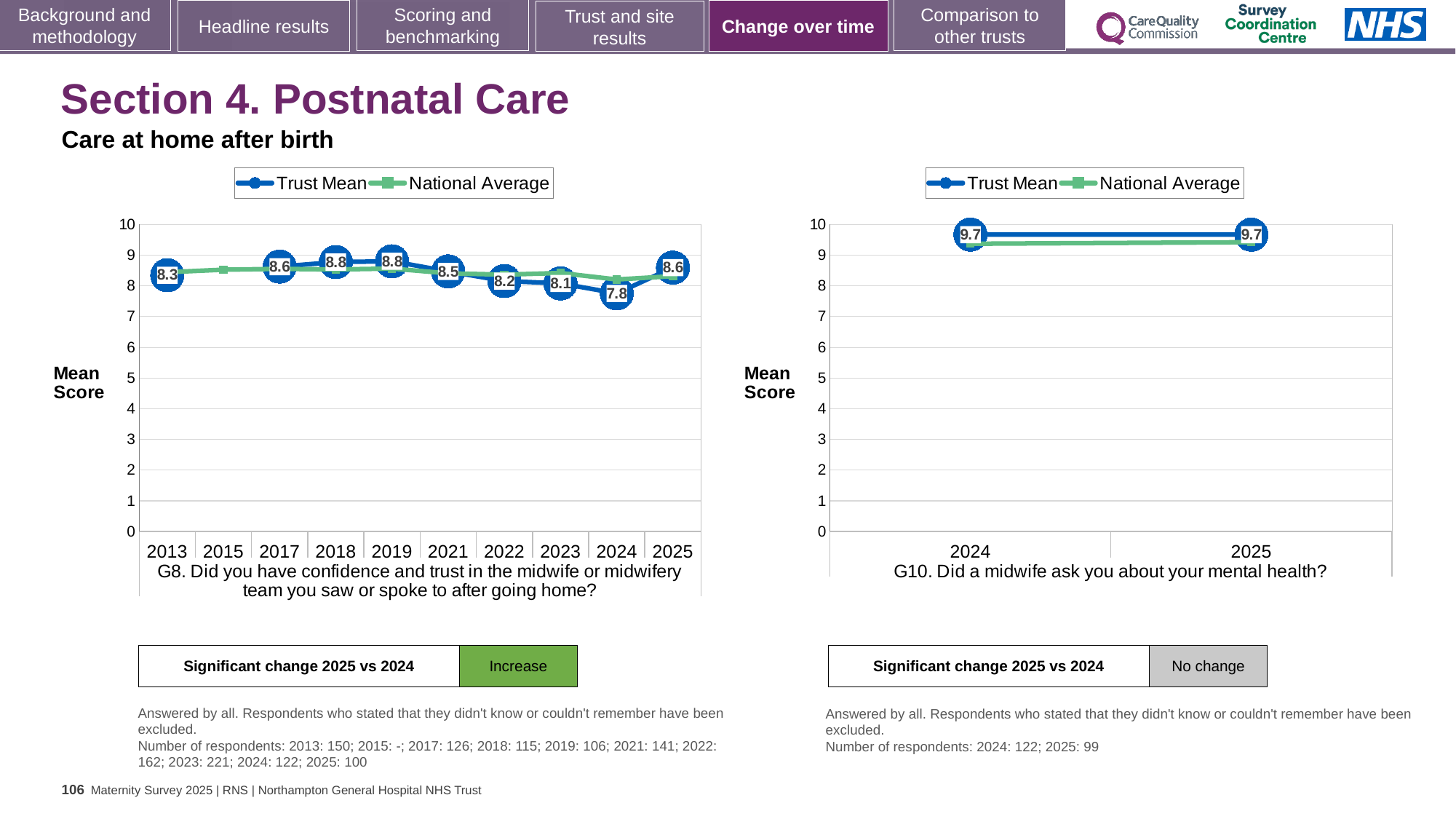
How many series does the legend of the G10 chart list? 2 In the G8 chart, which is larger, the Trust Mean for 2018 or for 2022? 2018 In the G8 chart, what is the Trust Mean score for 2024? 7.8 How many years are shown on the x axis of the G8 chart? 10 In the G10 chart, what is the difference between the Trust Mean scores for 2024 and 2025? 0 In the G8 chart, which year has the lowest Trust Mean score? 2024 In the G10 chart, what is the Trust Mean score for 2025? 9.7 In the G8 chart, what is the difference between the Trust Mean scores for 2025 and 2024? 0.8 In the G8 chart, is the Trust Mean value for 2023 greater or less than 9? less In the G8 chart, what is the Trust Mean score for 2013? 8.3 What kind of chart is the G8 chart? Line chart In the G8 chart, what is the Trust Mean score for 2025? 8.6